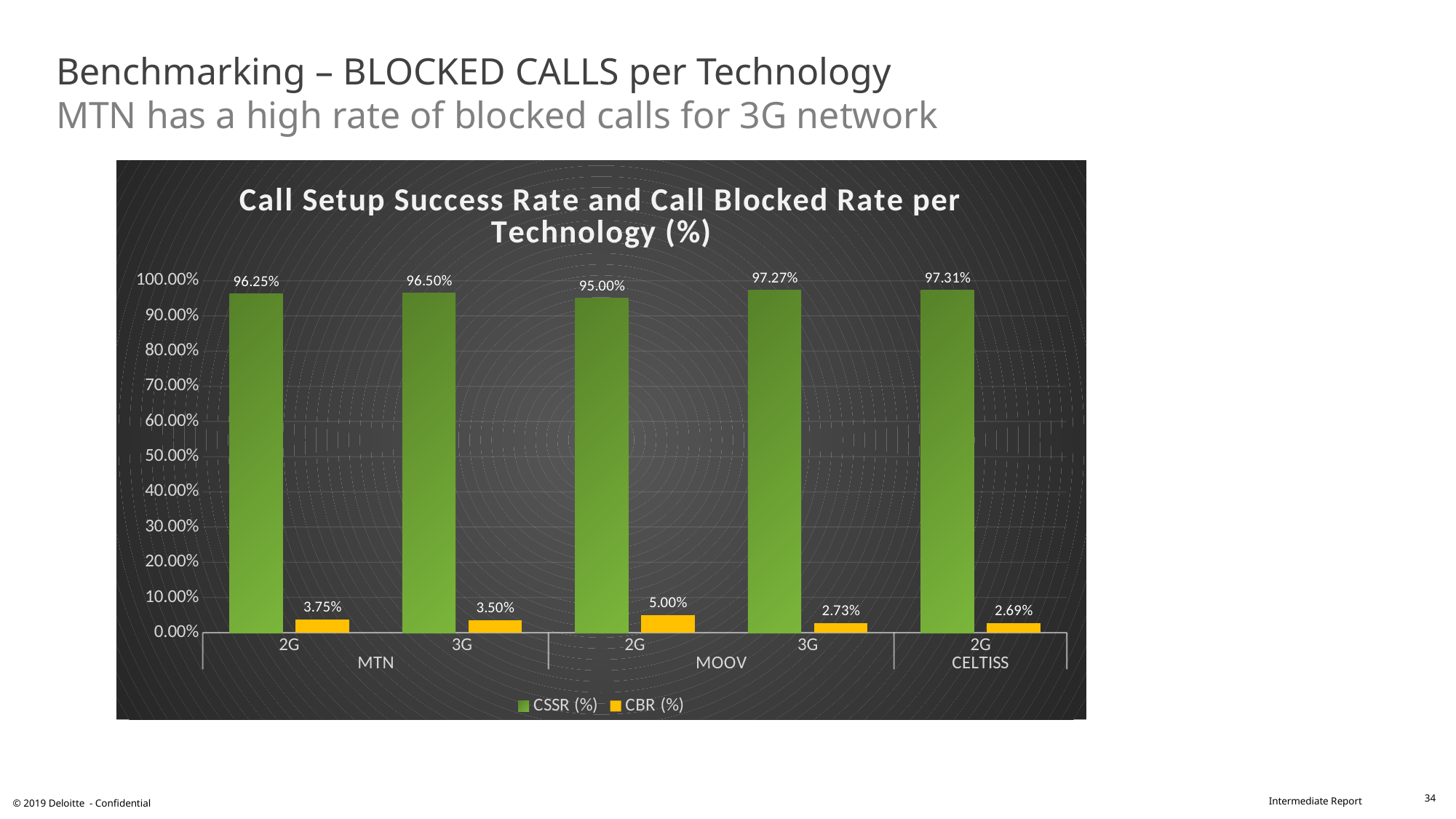
What is the difference between the CSSR (%) for MOOV 3G and MOOV 2G? 2.27% Which operator and technology has the lowest CSSR (%)? MOOV 2G How many operator/technology categories are shown on the x axis? 5 How many series does the legend list? 2 Which operator and technology has the highest CBR (%)? MOOV 2G Is the CSSR (%) value for MOOV 2G greater or less than 90.00%? greater What is the CBR (%) value for MTN 3G? 3.50% What is the CBR (%) value for MOOV 2G? 5.00% What is the CSSR (%) value for CELTISS 2G? 97.31% What is the CSSR (%) value for MTN 2G? 96.25% What kind of chart is shown on the slide? Bar chart Which is larger, the CBR (%) for MTN 2G or the CBR (%) for MOOV 3G? MTN 2G